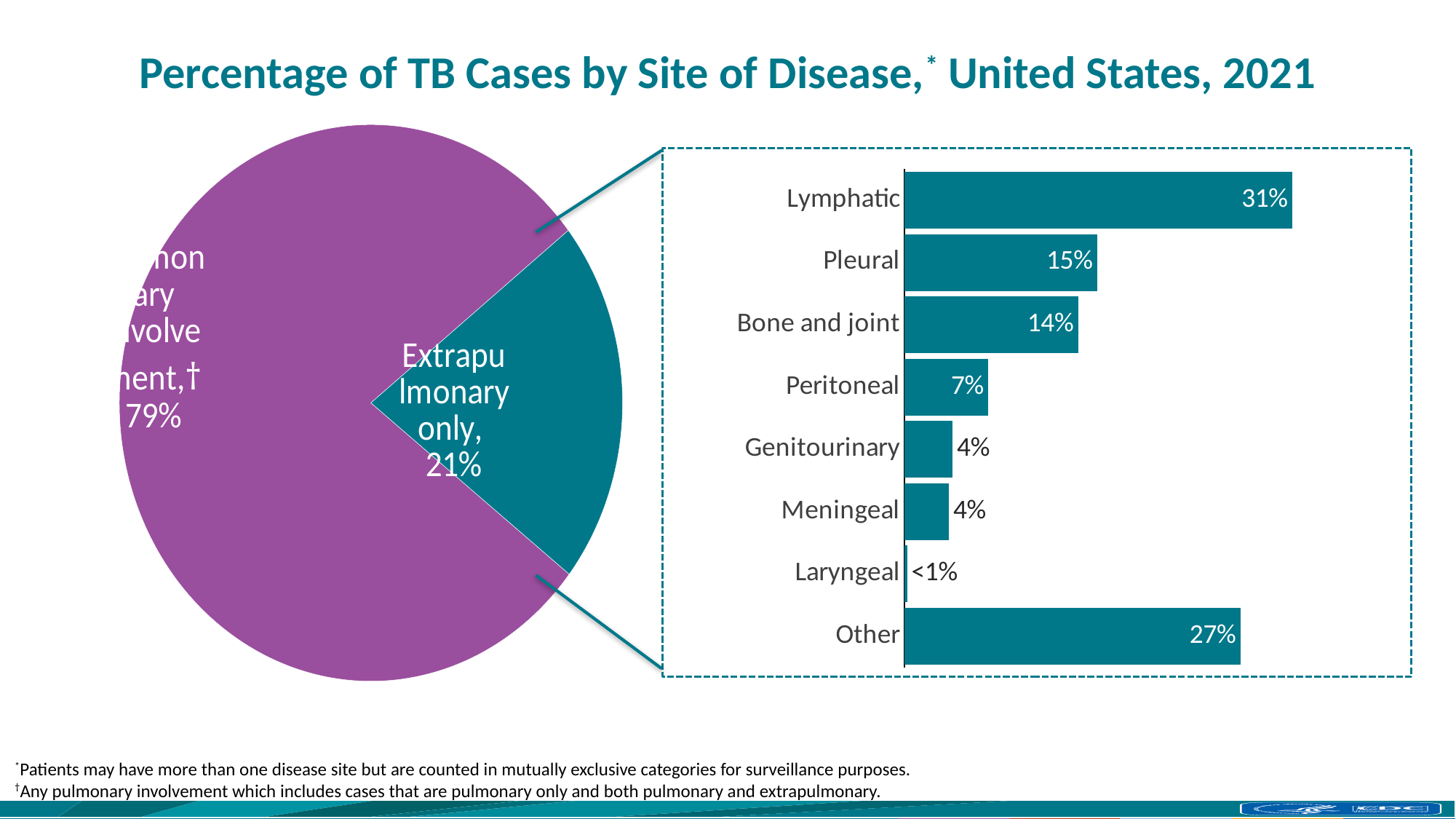
What kind of chart is shown on the left side of the slide? Pie chart In the pie chart on the left, what percentage of TB cases is labelled as Extrapulmonary only? 21% In the bar chart on the right, what is the difference between the Lymphatic and Other percentages? 4 percentage points In the bar chart on the right, which site of disease has the highest percentage? Lymphatic In the bar chart on the right, what is the value shown for Laryngeal? <1% In the bar chart on the right, which is larger, Pleural or Bone and joint? Pleural In the bar chart on the right, which site of disease has the lowest percentage? Laryngeal In the bar chart on the right, what is the difference between the Pleural and Peritoneal percentages? 8 percentage points In the bar chart on the right, what is the value for Peritoneal? 7% How many sites of disease are listed in the bar chart on the right? 8 In the bar chart on the right, what is the value for Other? 27% In the bar chart on the right, what is the value for Lymphatic? 31%